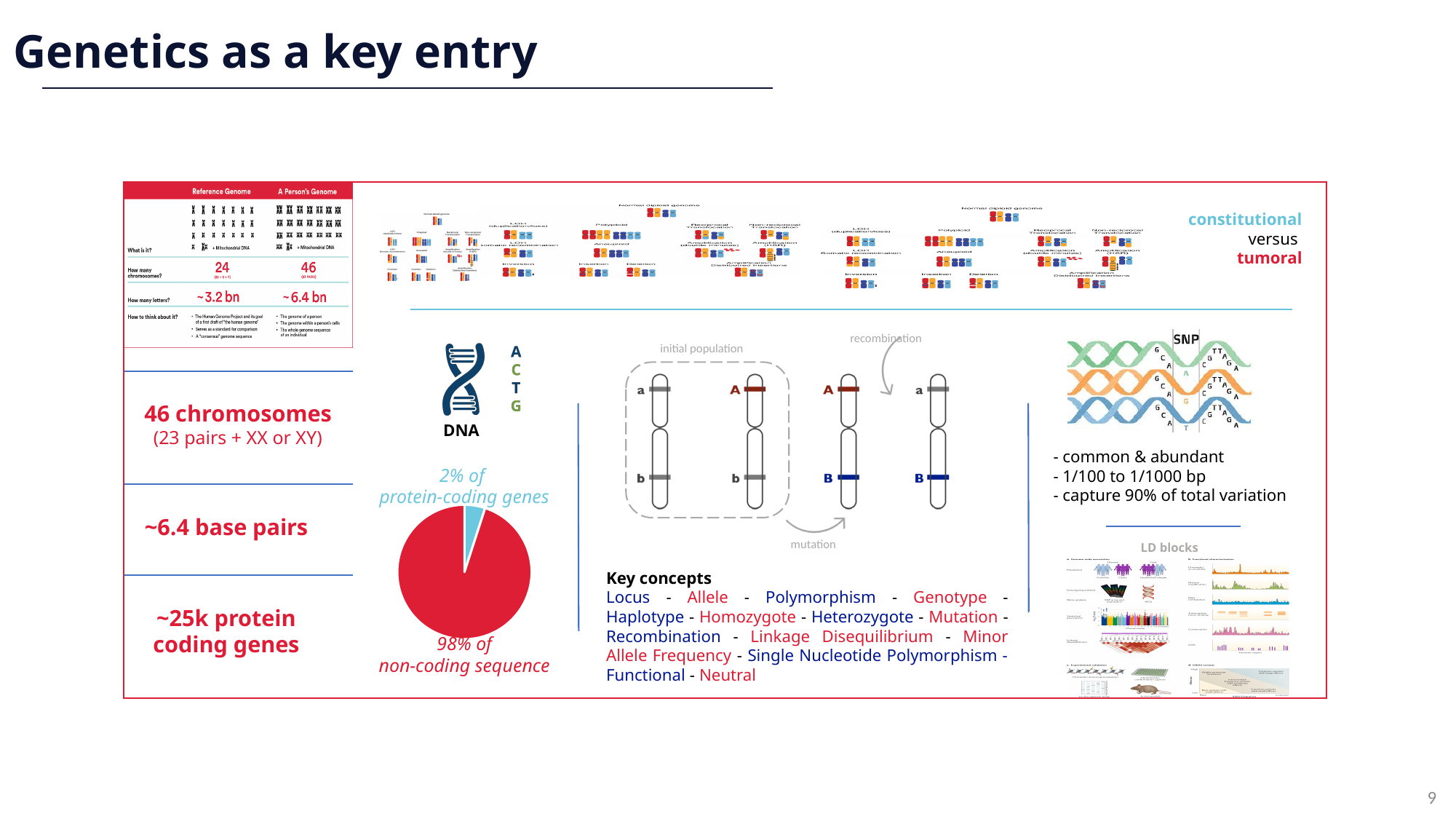
In the pie chart, what is the difference in percentage points between the non-coding sequence slice and the protein-coding genes slice? 96 Which slice of the pie chart is the largest? non-coding sequence What colour is the non-coding sequence slice in the pie chart? red In the pie chart, do the two slices add up to 100%? yes In the pie chart, what share of the genome is non-coding sequence? 98% What colour is the protein-coding genes slice in the pie chart? light blue How many slices does the pie chart have? 2 In the pie chart, which is larger: the protein-coding genes slice or the non-coding sequence slice? non-coding sequence What kind of chart is shown below the DNA icon on the slide? pie chart Which slice of the pie chart is the smallest? protein-coding genes In the pie chart, what share of the genome is protein-coding genes? 2%